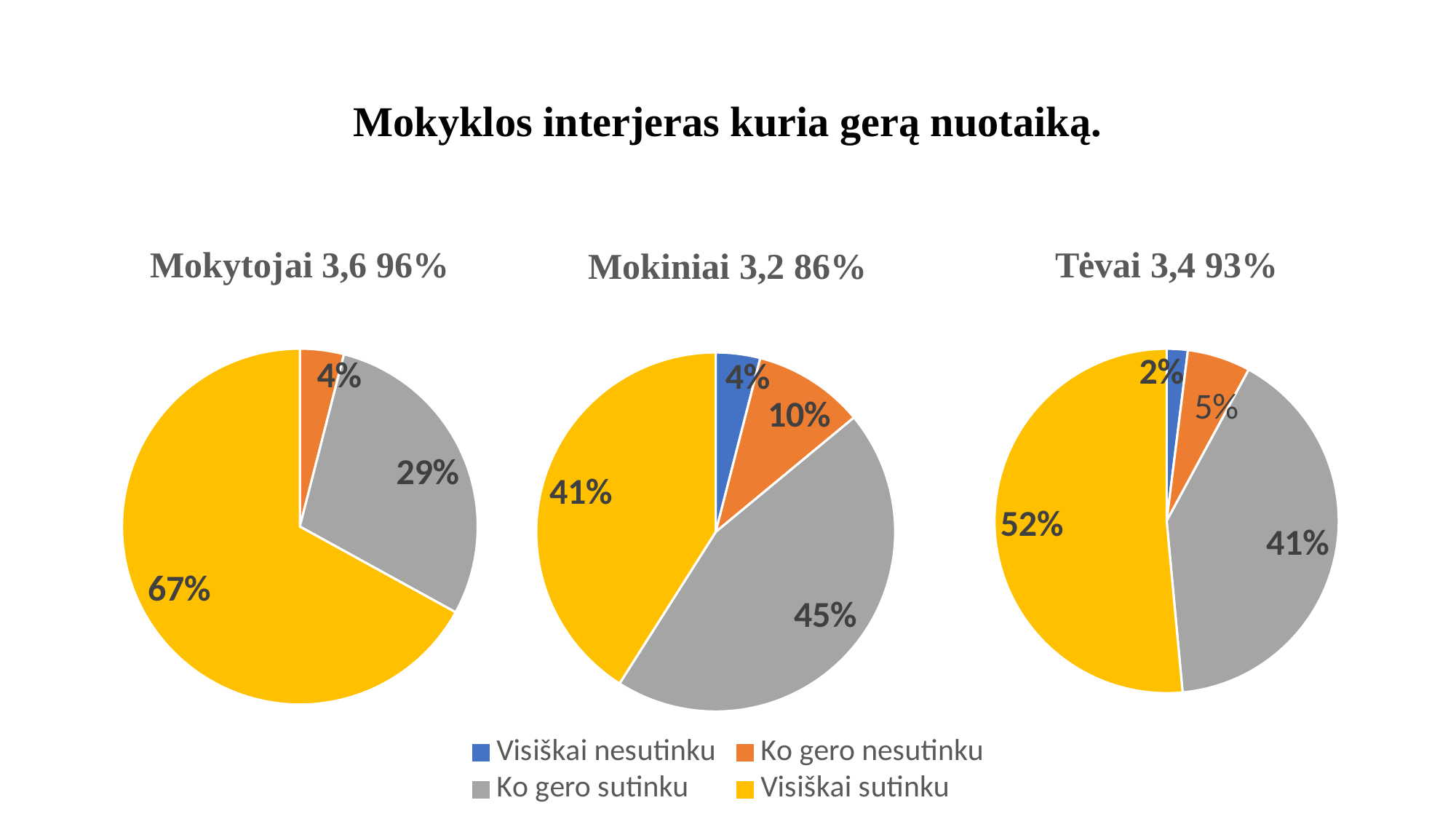
Which is larger: the Visiškai sutinku share in the Mokytojai 3,6 96% chart or in the Tėvai 3,4 93% chart? Mokytojai 3,6 96% In the Mokytojai 3,6 96% pie chart, what share is labelled for Ko gero sutinku? 29% What type of chart is used on this slide? Pie chart In the Mokiniai 3,2 86% pie chart, what is the difference between the Ko gero sutinku share and the Visiškai sutinku share? 4% In the Mokytojai 3,6 96% pie chart, what share is labelled for Visiškai sutinku? 67% In the Mokiniai 3,2 86% pie chart, which category has the largest slice? Ko gero sutinku In the Tėvai 3,4 93% pie chart, which category has the smallest slice? Visiškai nesutinku In the Tėvai 3,4 93% pie chart, what share is labelled for Visiškai sutinku? 52% How many entries does the legend list? 4